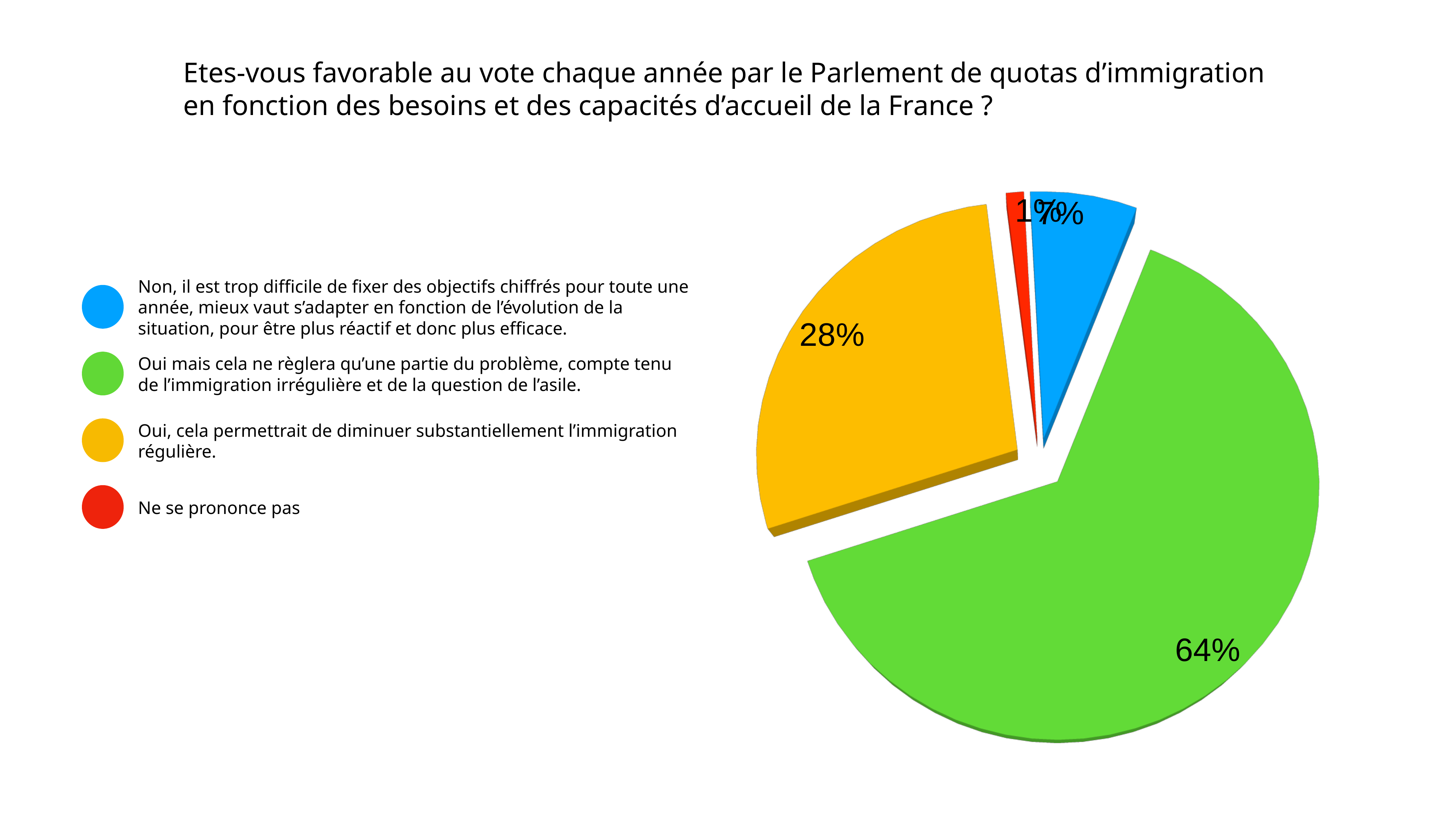
Which answer has the smallest share of the pie? Ne se prononce pas What percentage of respondents chose the "Non, il est trop difficile de fixer des objectifs chiffrés..." answer? 7% How many slices does the pie chart have? 4 What percentage of respondents chose "Oui mais cela ne règlera qu'une partie du problème, compte tenu de l'immigration irrégulière et de la question de l'asile"? 64% What kind of chart is shown on the slide? Pie chart What colour represents "Ne se prononce pas" in the chart? Red Which is larger: the share for "Oui, cela permettrait de diminuer substantiellement l'immigration régulière" or the share for "Non, il est trop difficile de fixer des objectifs chiffrés..."? Oui, cela permettrait de diminuer substantiellement l'immigration régulière. What is the difference in percentage points between the green slice (64%) and the yellow slice (28%)? 36 What percentage of respondents answered "Ne se prononce pas"? 1% What percentage of respondents chose "Oui, cela permettrait de diminuer substantiellement l'immigration régulière"? 28% Which answer has the largest share of the pie? Oui mais cela ne règlera qu'une partie du problème, compte tenu de l'immigration irrégulière et de la question de l'asile. What colour is the slice for "Oui, cela permettrait de diminuer substantiellement l'immigration régulière"? Yellow